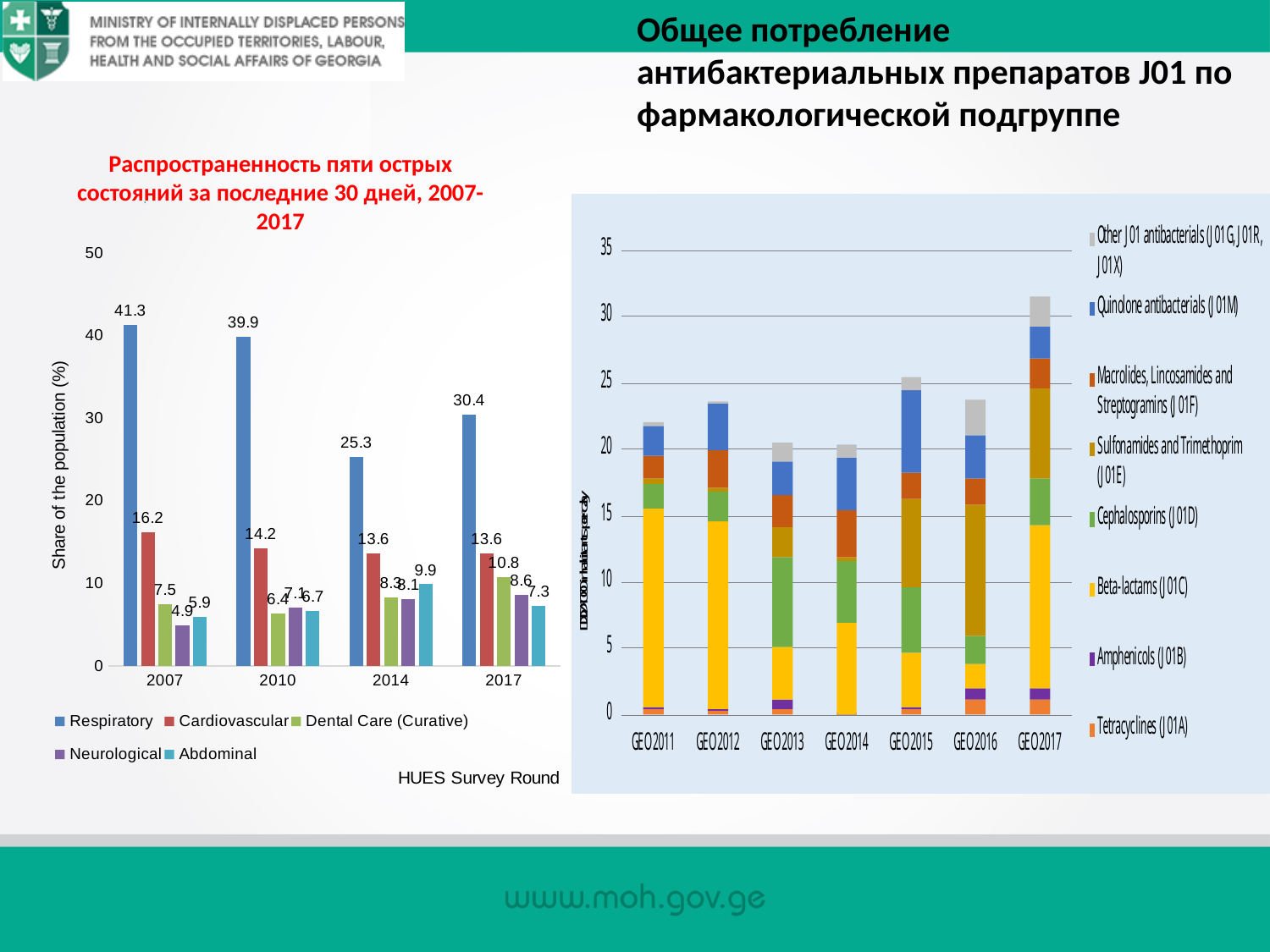
In the right chart (Общее потребление антибактериальных препаратов J01), which year has the highest total stacked bar? GEO2017 In the right chart (Общее потребление антибактериальных препаратов J01), is the total for GEO2017 greater or less than 30? greater In the left chart (Распространенность пяти острых состояний), what is the difference between the Respiratory values for 2007 and 2017? 10.9 In the right chart (Общее потребление антибактериальных препаратов J01), how many series does the legend list? 8 In the left chart (Распространенность пяти острых состояний), what is the value for Respiratory in 2007? 41.3 In the left chart (Распространенность пяти острых состояний), which is larger: Cardiovascular in 2007 or Cardiovascular in 2010? Cardiovascular in 2007 In the left chart (Распространенность пяти острых состояний), which survey year has the lowest Respiratory value? 2014 What kind of chart is the right chart (Общее потребление антибактериальных препаратов J01)? Stacked bar chart In the left chart (Распространенность пяти острых состояний), what is the value for Dental Care (Curative) in 2017? 10.8 In the left chart (Распространенность пяти острых состояний), how many survey years are shown on the x axis? 4 In the left chart (Распространенность пяти острых состояний), how many series does the legend list? 5 In the left chart (Распространенность пяти острых состояний), what is the value for Abdominal in 2014? 9.9